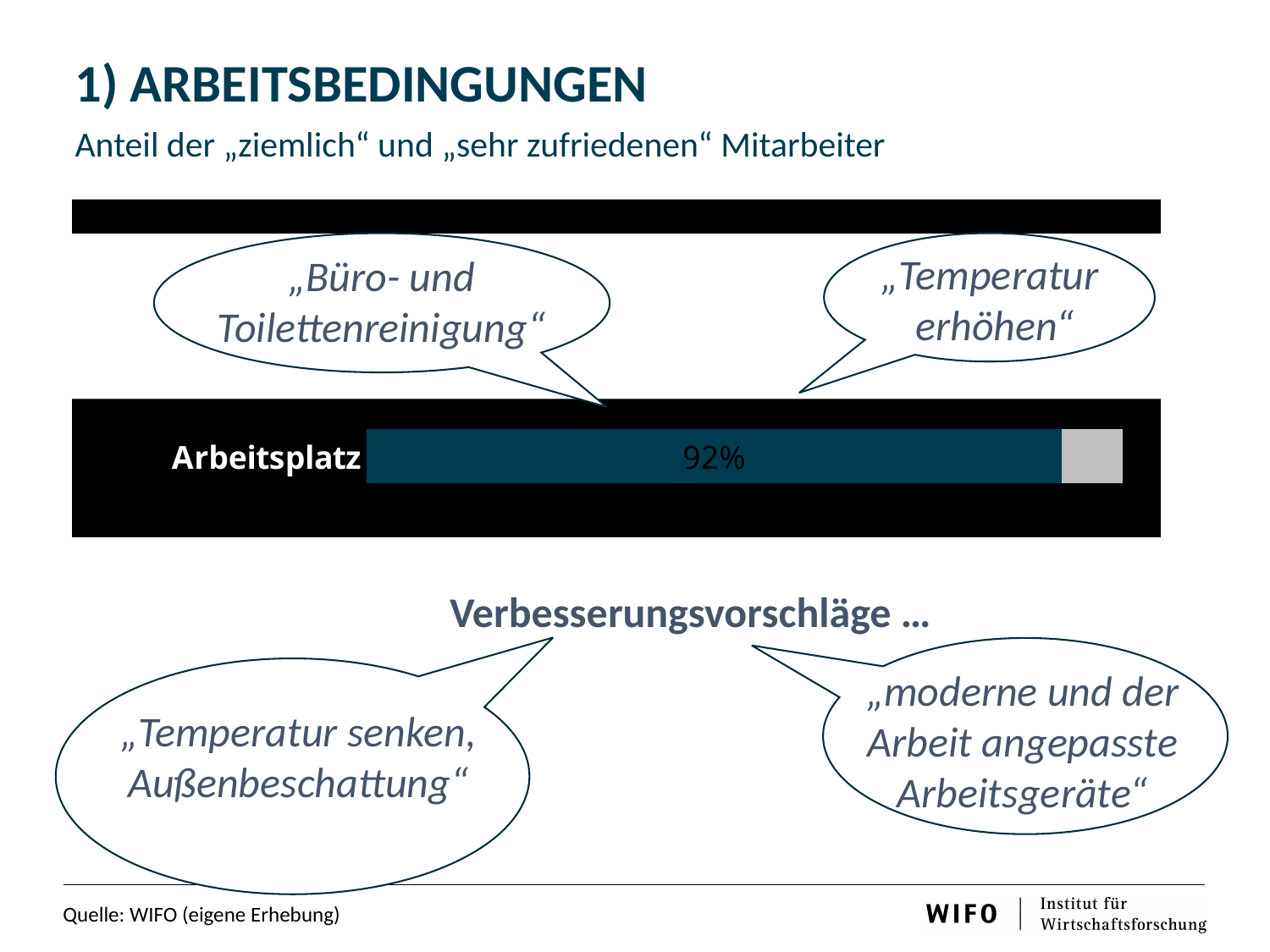
What is the label of the single category in the bar chart? Arbeitsplatz How many categories does the bar chart show? 1 What is the value shown for Arbeitsplatz in the bar chart? 92% What does the subtitle say the chart measures? Anteil der „ziemlich“ und „sehr zufriedenen“ Mitarbeiter Is the bar for Arbeitsplatz oriented horizontally or vertically? horizontally What kind of chart is shown on the slide? bar chart